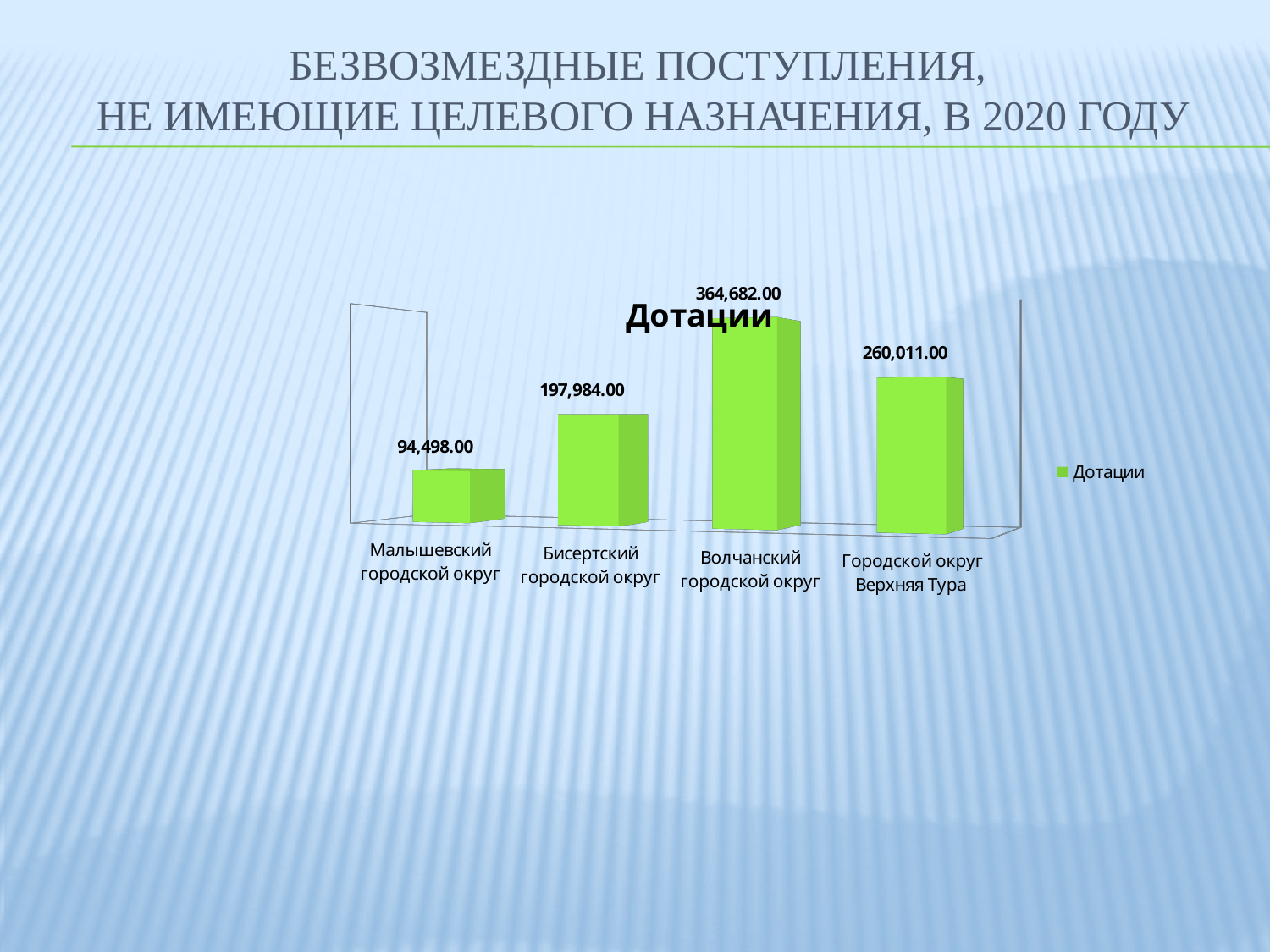
What is the difference between the values for Волчанский городской округ and Малышевский городской округ? 270,184.00 What kind of chart is shown on the slide? Bar chart What is the value for Малышевский городской округ? 94,498.00 Which category has the lowest value? Малышевский городской округ What is the difference between the values for Городской округ Верхняя Тура and Бисертский городской округ? 62,027.00 Which category has the highest value? Волчанский городской округ What is the value for Волчанский городской округ? 364,682.00 What is the value for Бисертский городской округ? 197,984.00 How many categories are shown in the chart? 4 What is the value for Городской округ Верхняя Тура? 260,011.00 Which is larger, the value for Бисертский городской округ or the value for Городской округ Верхняя Тура? Городской округ Верхняя Тура What is the title of the chart? Дотации